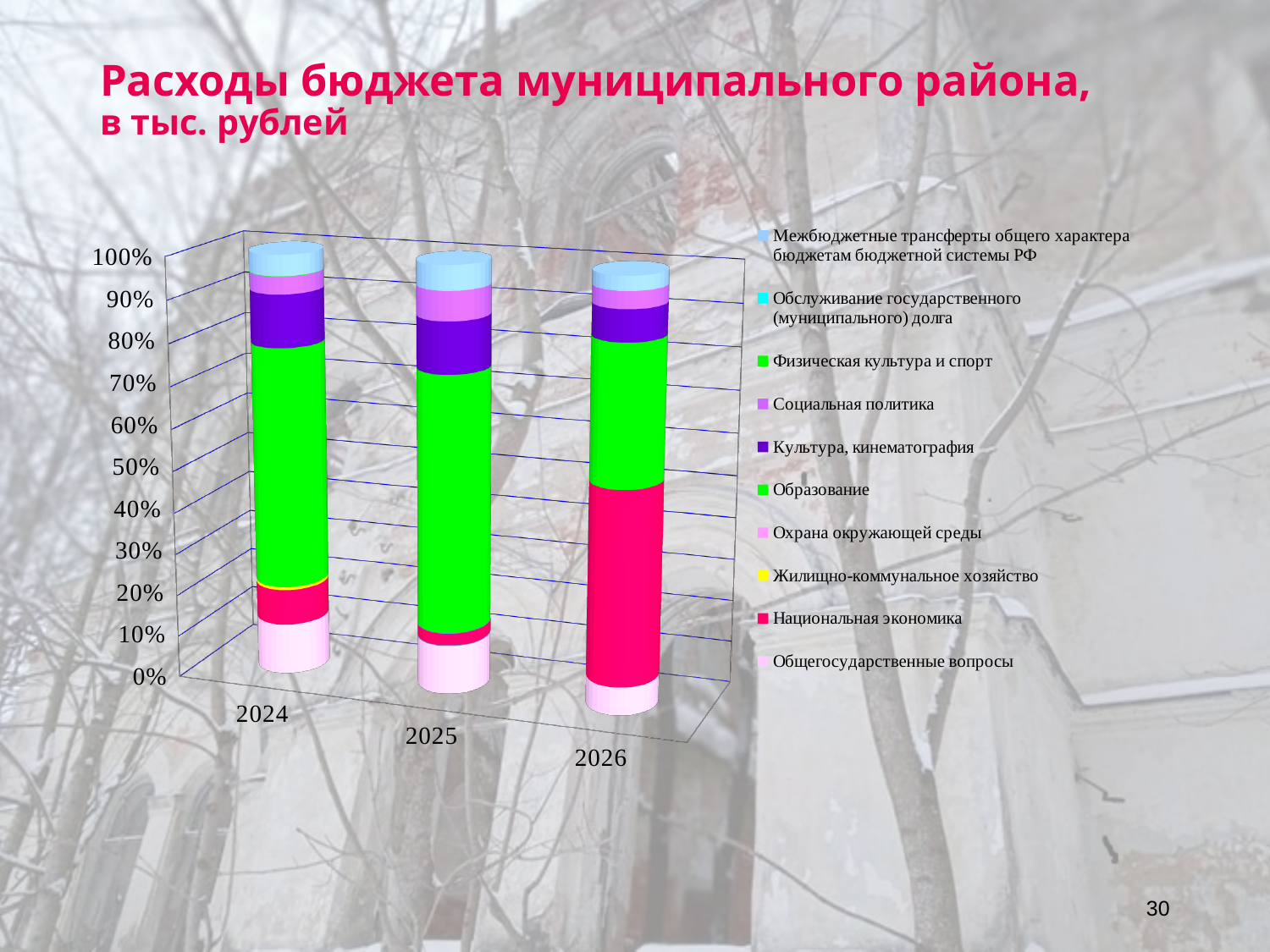
In which year is the share of Национальная экономика the largest? 2026 What kind of chart is shown on the slide? Stacked bar chart What is the title of the chart on the slide? Расходы бюджета муниципального района, в тыс. рублей Is the share of Национальная экономика in 2026 greater or less than 20%? greater Which colour represents Образование in the chart? Green How many years are shown along the x axis of the chart? 3 Is the share of Общегосударственные вопросы in 2024 greater or less than 20%? less Is the share of Культура, кинематография in 2025 greater or less than 20%? less Which year has the larger share of Национальная экономика, 2024 or 2026? 2026 How many series does the chart legend list? 10 In which year is the share of Образование the smallest? 2026